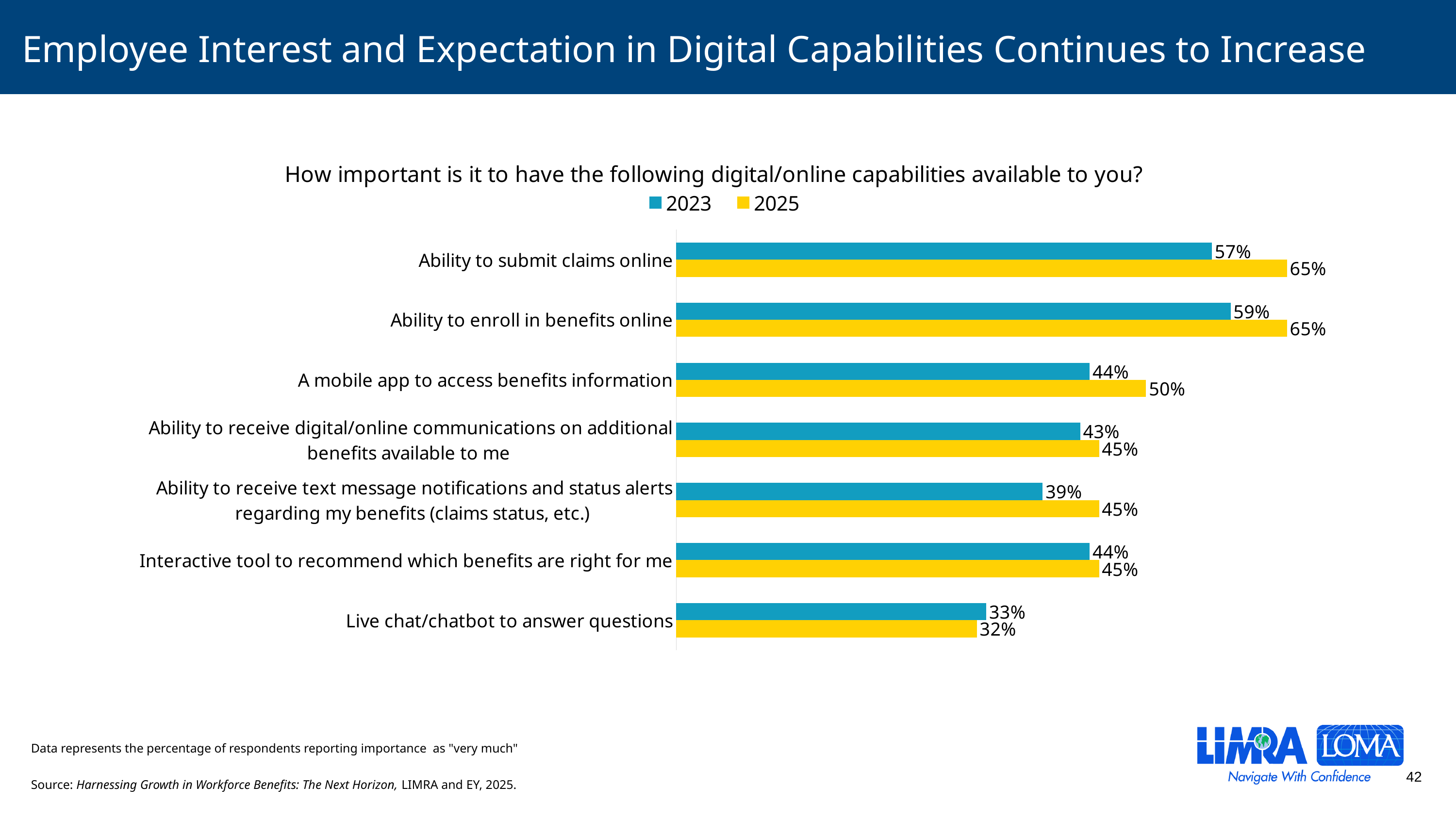
What is the 2025 value for 'Ability to submit claims online'? 65% How many categories are shown in the chart? 7 What is the 2025 value for 'A mobile app to access benefits information'? 50% How many series does the legend list? 2 For 'Live chat/chatbot to answer questions', which year has the larger value, 2023 or 2025? 2023 Which category has the lowest 2025 value? Live chat/chatbot to answer questions What is the 2023 value for 'Live chat/chatbot to answer questions'? 33% What is the difference between the 2025 and 2023 values for 'Ability to submit claims online'? 8% What is the 2023 value for 'Ability to receive text message notifications and status alerts regarding my benefits (claims status, etc.)'? 39% What kind of chart is shown on the slide? Bar chart Which category has the highest 2023 value? Ability to enroll in benefits online What is the difference between the 2025 and 2023 values for 'A mobile app to access benefits information'? 6%